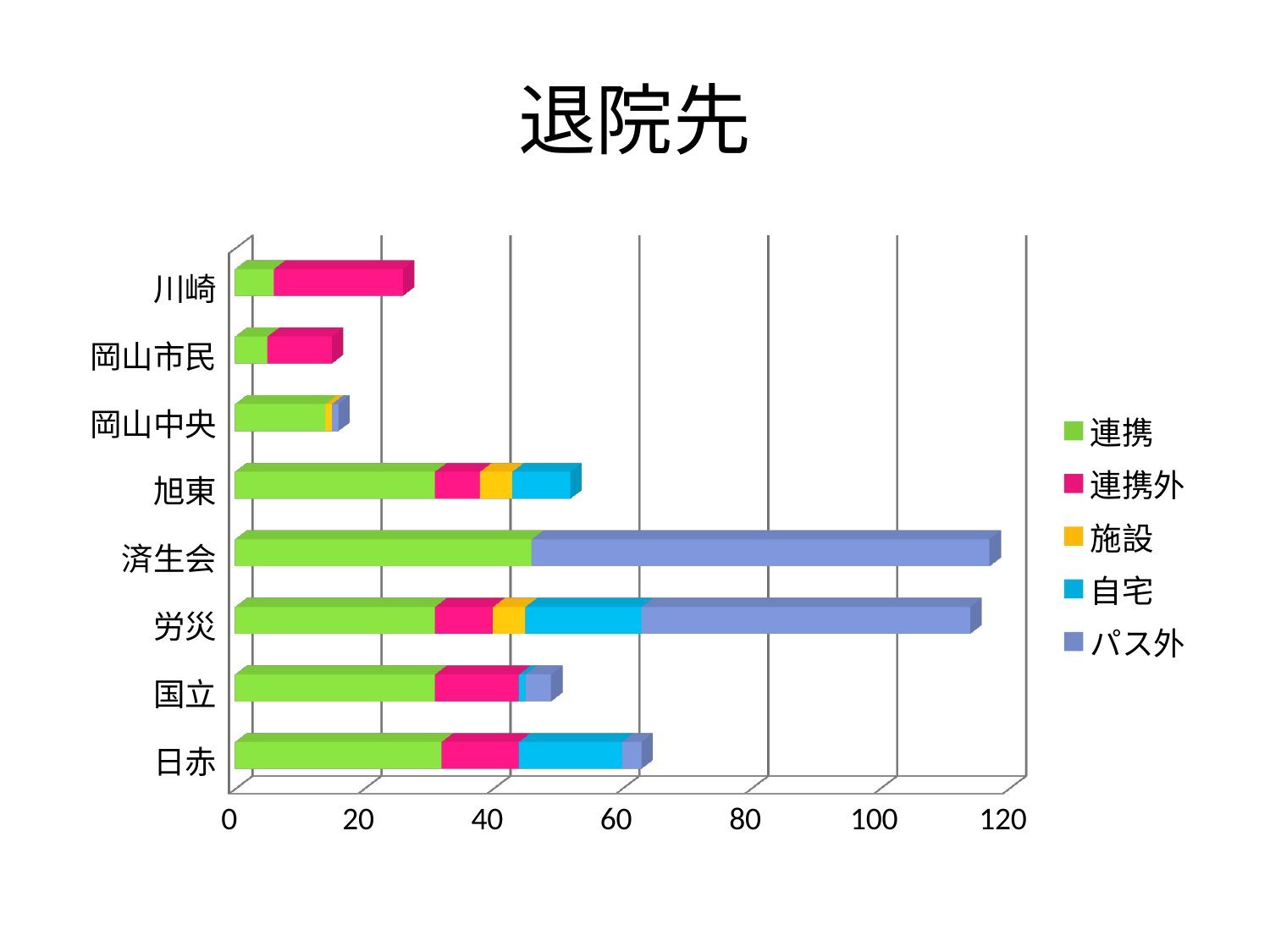
Is the total bar length for 済生会 greater or less than 100? greater What is the title of the chart? 退院先 Is the total bar length for 岡山市民 greater or less than 20? less Which has the longer total bar, 済生会 or 旭東? 済生会 What kind of chart is shown on the slide? Stacked bar chart Is the total bar length for 旭東 greater or less than 40? greater Which series is shown in green in the legend? 連携 How many series does the legend list? 5 How many categories (hospitals) are shown on the vertical axis? 8 Which has the longer total bar, 川崎 or 岡山市民? 川崎 Which has the longer total bar, 日赤 or 国立? 日赤